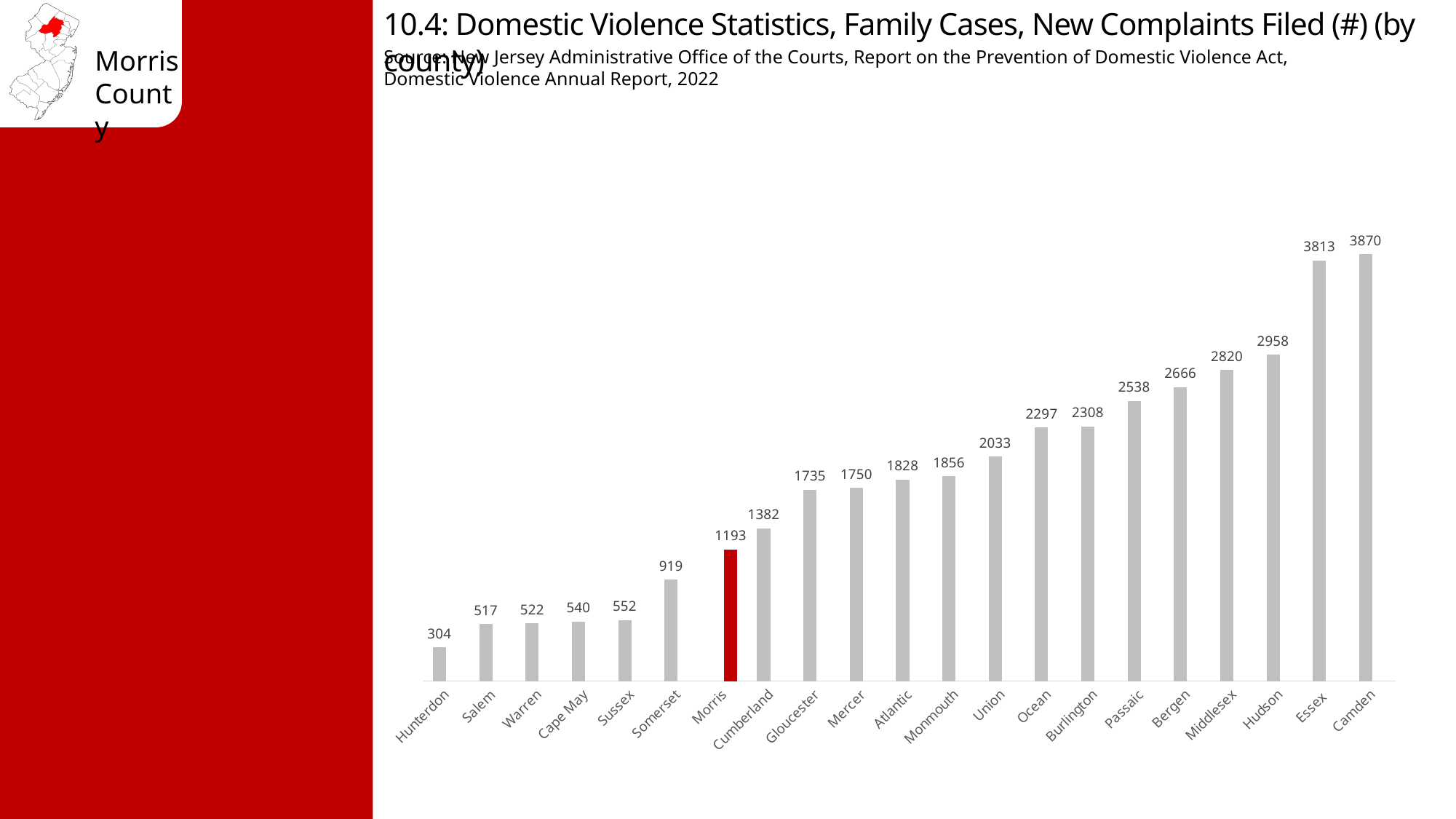
How many counties are shown in the chart? 21 What is the number of new domestic violence family case complaints filed for Morris County? 1193 Which has a larger value, Hudson or Passaic? Hudson What is the value shown for Camden? 3870 What is the difference between the values for Morris and Hunterdon? 889 Which has a larger value, Union or Cumberland? Union What is the difference between the values for Camden and Essex? 57 What is the value shown for Somerset? 919 Which county has the highest number of new complaints filed? Camden Do the values rise or fall from left to right across the counties? Rise What kind of chart is shown on the slide? Bar chart Which county has the lowest number of new complaints filed? Hunterdon